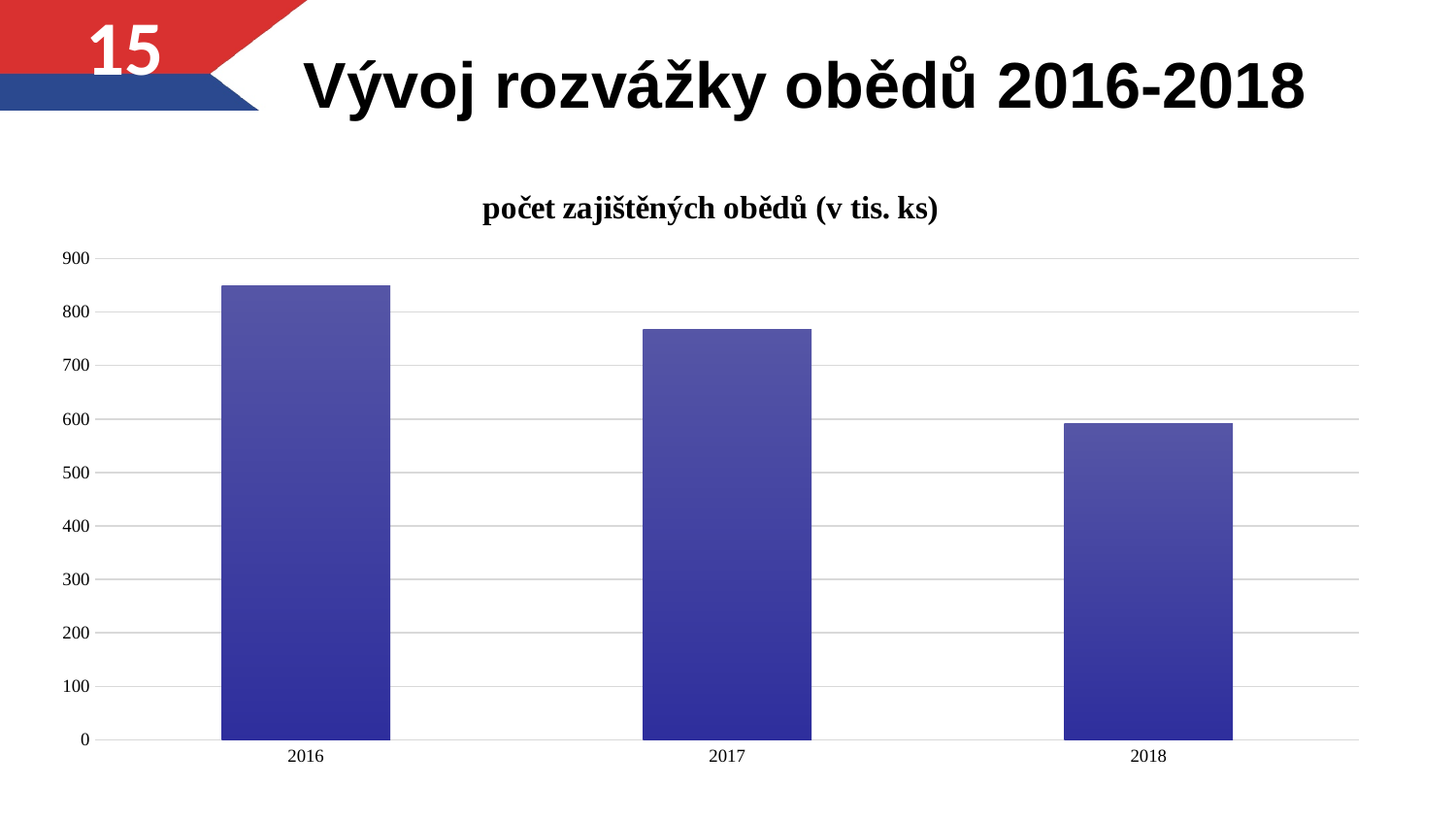
What is the title of the chart? počet zajištěných obědů (v tis. ks) Which year has the highest number of delivered lunches? 2016 Is the value for 2017 greater or less than 700? greater Is the value for 2017 greater or less than 800? less Is the value for 2016 greater or less than 800? greater Which is larger, the value for 2016 or the value for 2017? 2016 Which is larger, the value for 2017 or the value for 2018? 2017 Do the values rise or fall from 2016 to 2018? fall Which year has the lowest number of delivered lunches? 2018 How many years (categories) are shown on the x axis of the chart? 3 What kind of chart is shown on the slide? bar chart